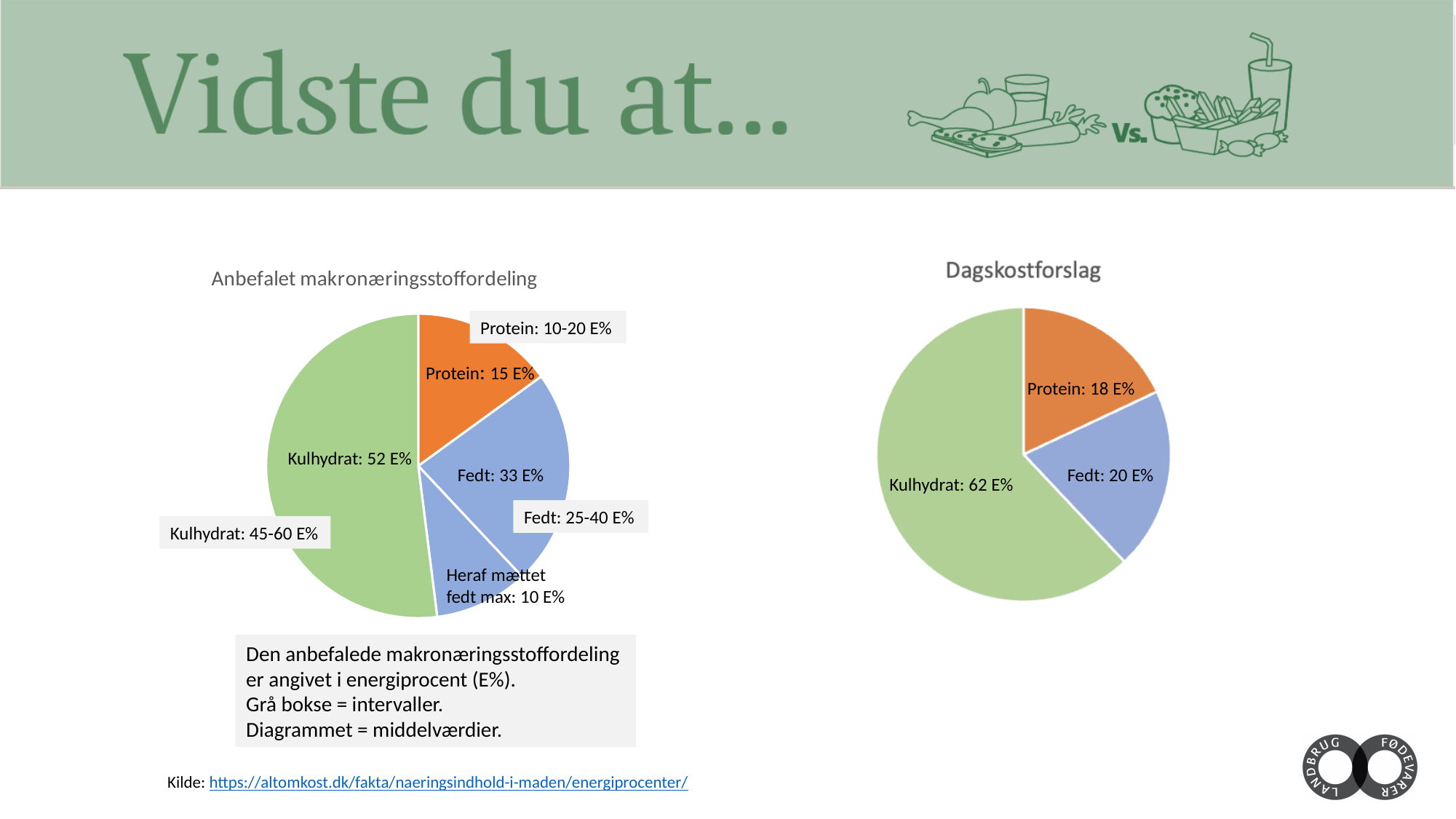
In the 'Anbefalet makronæringsstoffordeling' chart, what is the difference between Fedt and Protein? 18 E% In the 'Anbefalet makronæringsstoffordeling' chart, which category has the largest slice? Kulhydrat In the 'Anbefalet makronæringsstoffordeling' chart, what is the value for Fedt? 33 E% In the 'Dagskostforslag' chart, which category has the smallest slice? Protein Is the value for Protein larger in the 'Anbefalet makronæringsstoffordeling' chart or in the 'Dagskostforslag' chart? Dagskostforslag In the 'Dagskostforslag' chart, what is the value for Fedt? 20 E% What type of chart is 'Dagskostforslag'? Pie chart In the 'Dagskostforslag' chart, what is the value for Kulhydrat? 62 E% In the 'Anbefalet makronæringsstoffordeling' chart, what is the recommended interval shown for Kulhydrat? 45-60 E% In the 'Anbefalet makronæringsstoffordeling' chart, what colour is the Fedt slice? Blue In the 'Anbefalet makronæringsstoffordeling' chart, what is the value for Protein? 15 E% In the 'Dagskostforslag' chart, what is the difference between Kulhydrat and Fedt? 42 E%